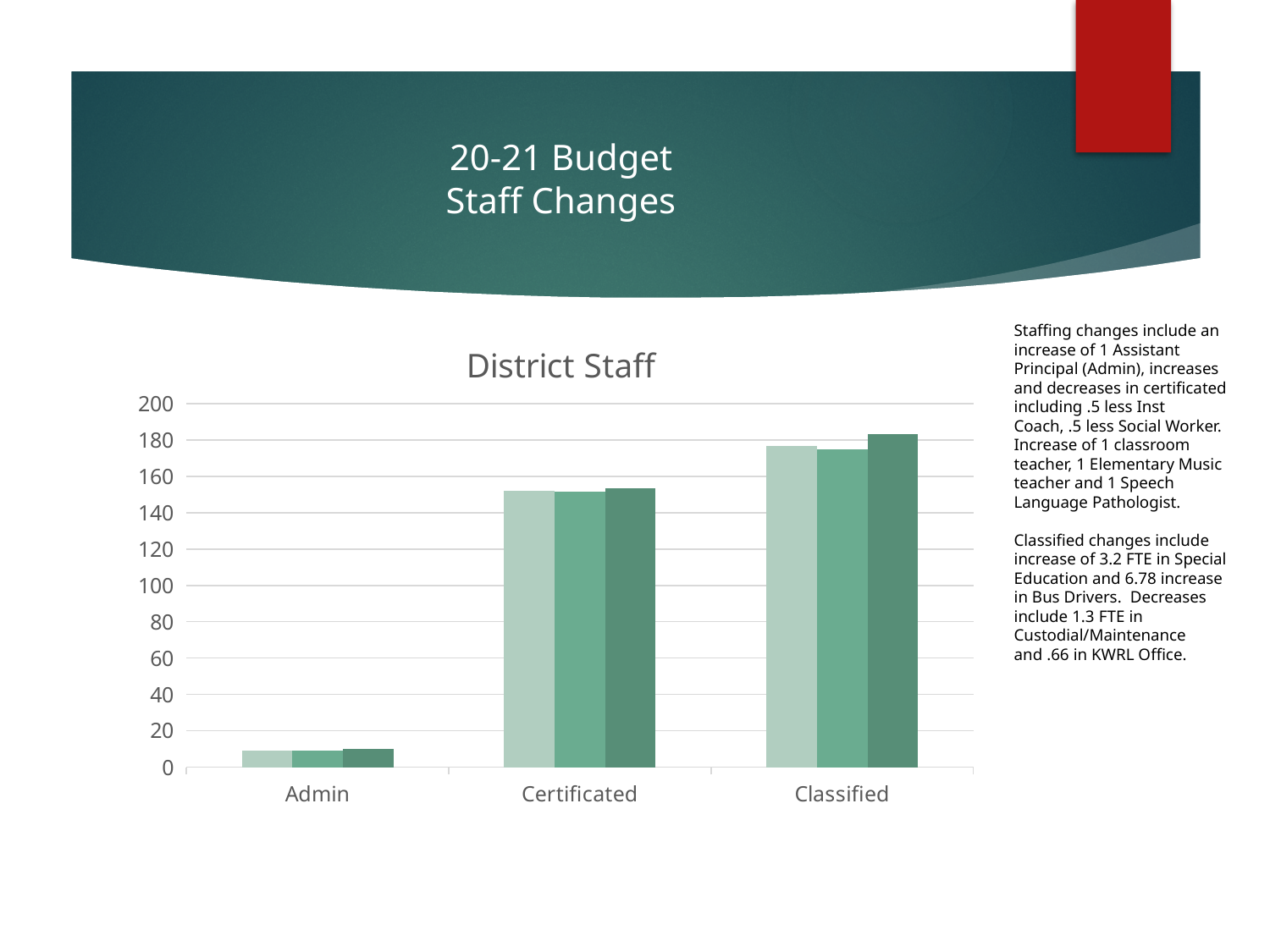
Are the values for Certificated greater or less than 160? less Are the values for Admin greater or less than 20? less Are the values for Certificated greater or less than 140? greater What is the title of the chart on the slide? District Staff What kind of chart is the District Staff chart? bar chart Which category has larger values, Certificated or Classified? Classified How many categories are shown on the x axis of the District Staff chart? 3 Which category has the highest values in the District Staff chart? Classified Which category has the lowest values in the District Staff chart? Admin Do the values rise or fall moving from Admin to Classified along the x axis? rise